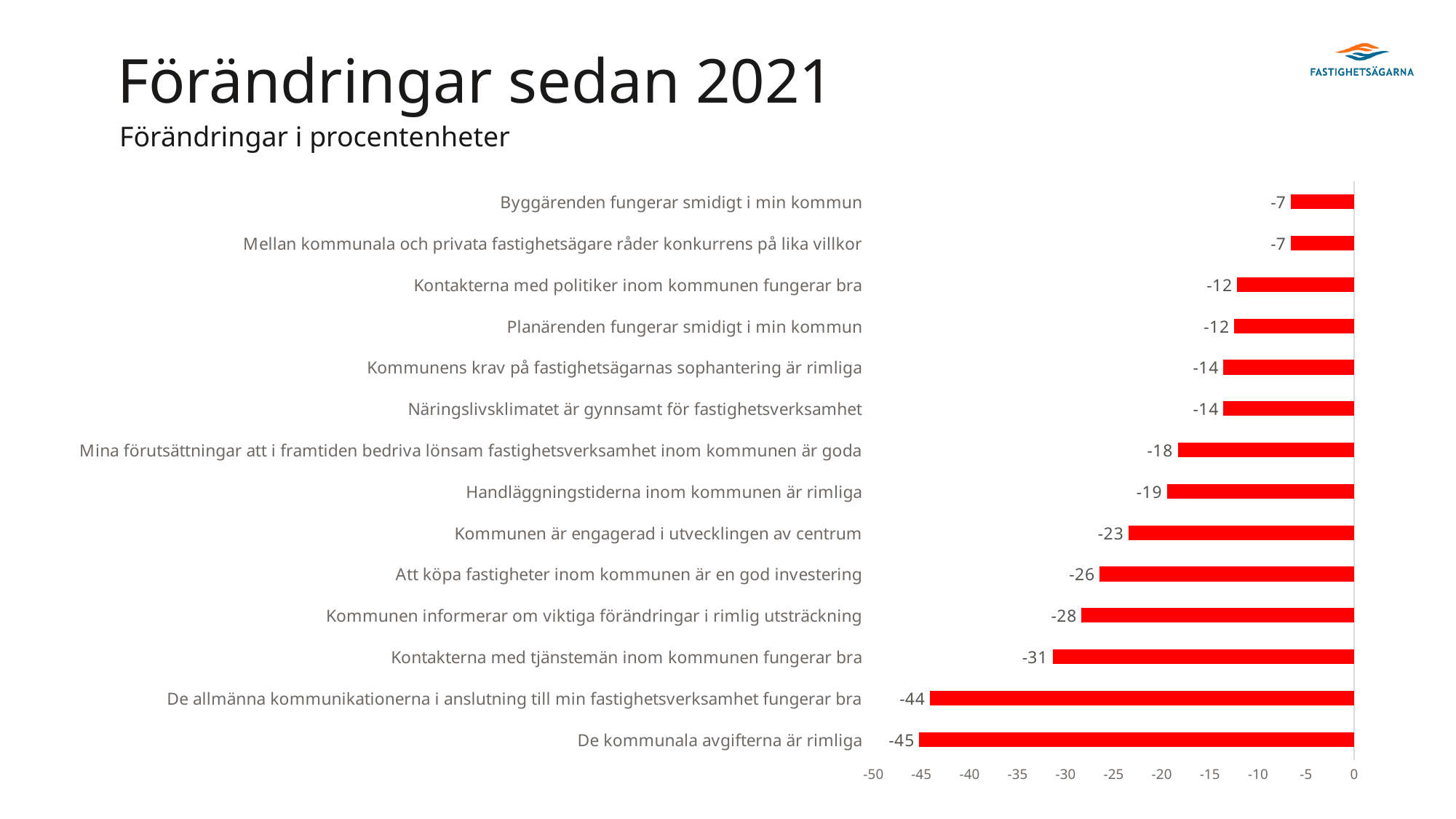
What is the value for "Byggärenden fungerar smidigt i min kommun"? -7 What is the value for "Handläggningstiderna inom kommunen är rimliga"? -19 What is the value for "De kommunala avgifterna är rimliga"? -45 What kind of chart is shown on the slide? Bar chart Is the value for "Kontakterna med tjänstemän inom kommunen fungerar bra" greater or less than -30? less What is the subtitle shown under the slide title? Förändringar i procentenheter What is the difference between the values for "Kommunen informerar om viktiga förändringar i rimlig utsträckning" and "Kommunen är engagerad i utvecklingen av centrum"? 5 What is the value for "Kontakterna med tjänstemän inom kommunen fungerar bra"? -31 Which has a more negative value: "Att köpa fastigheter inom kommunen är en god investering" or "Näringslivsklimatet är gynnsamt för fastighetsverksamhet"? Att köpa fastigheter inom kommunen är en god investering How many categories are shown in the chart? 14 What is the difference between the values for "De kommunala avgifterna är rimliga" and "De allmänna kommunikationerna i anslutning till min fastighetsverksamhet fungerar bra"? 1 Which category has the lowest (most negative) value? De kommunala avgifterna är rimliga